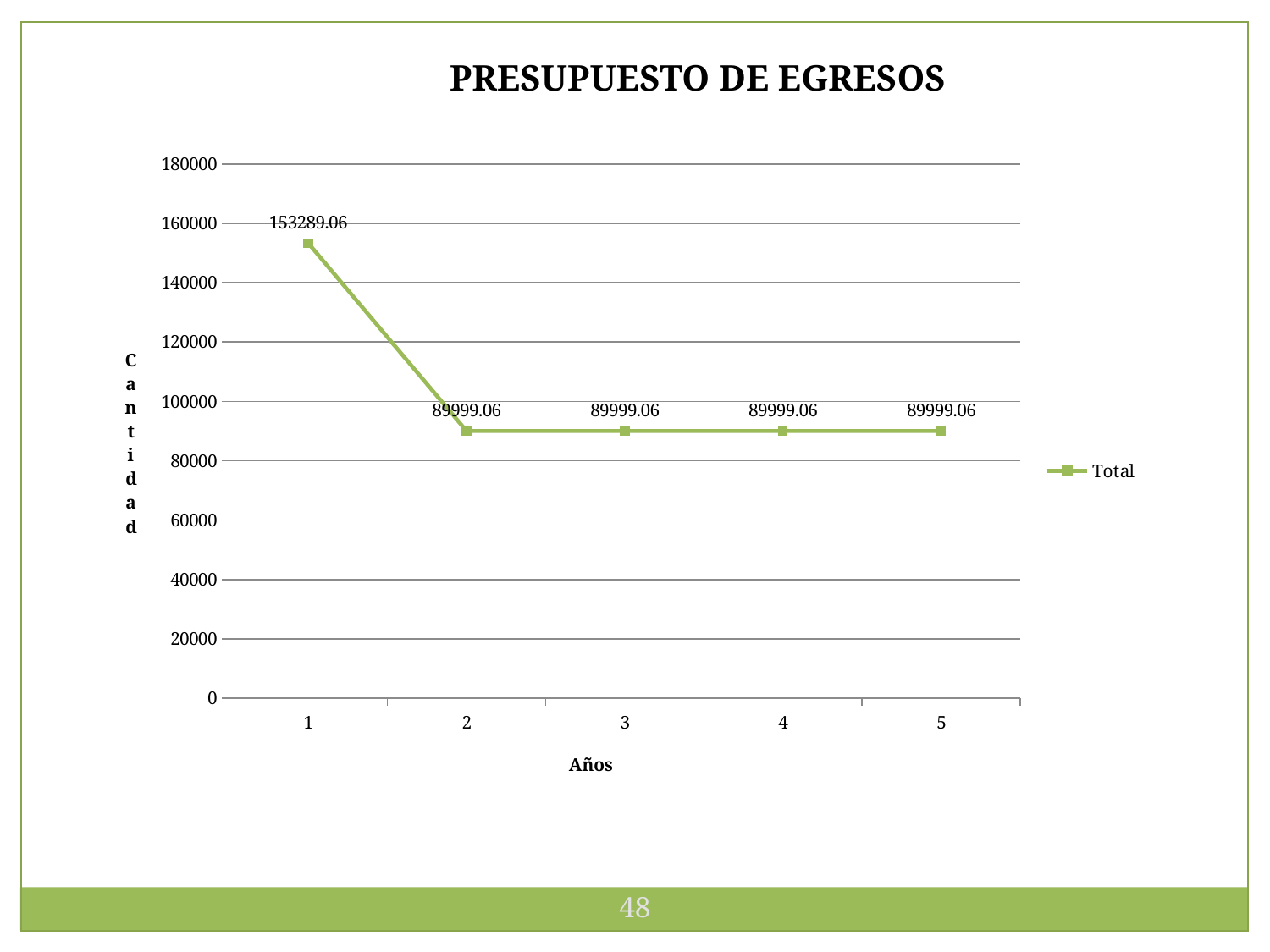
Is the value for year 2 greater or less than 100000? less How many series does the legend list? 1 Is the value for year 1 greater or less than 140000? greater What is the title of the chart? PRESUPUESTO DE EGRESOS What is the value for year 3? 89999.06 What is the value for year 5? 89999.06 What is the difference between the value for year 1 and the value for year 2? 63290 Which year has the highest value? 1 How many years are plotted on the x axis? 5 Which is larger, the value for year 1 or the value for year 4? year 1 What kind of chart is shown? line chart What is the value for year 1? 153289.06